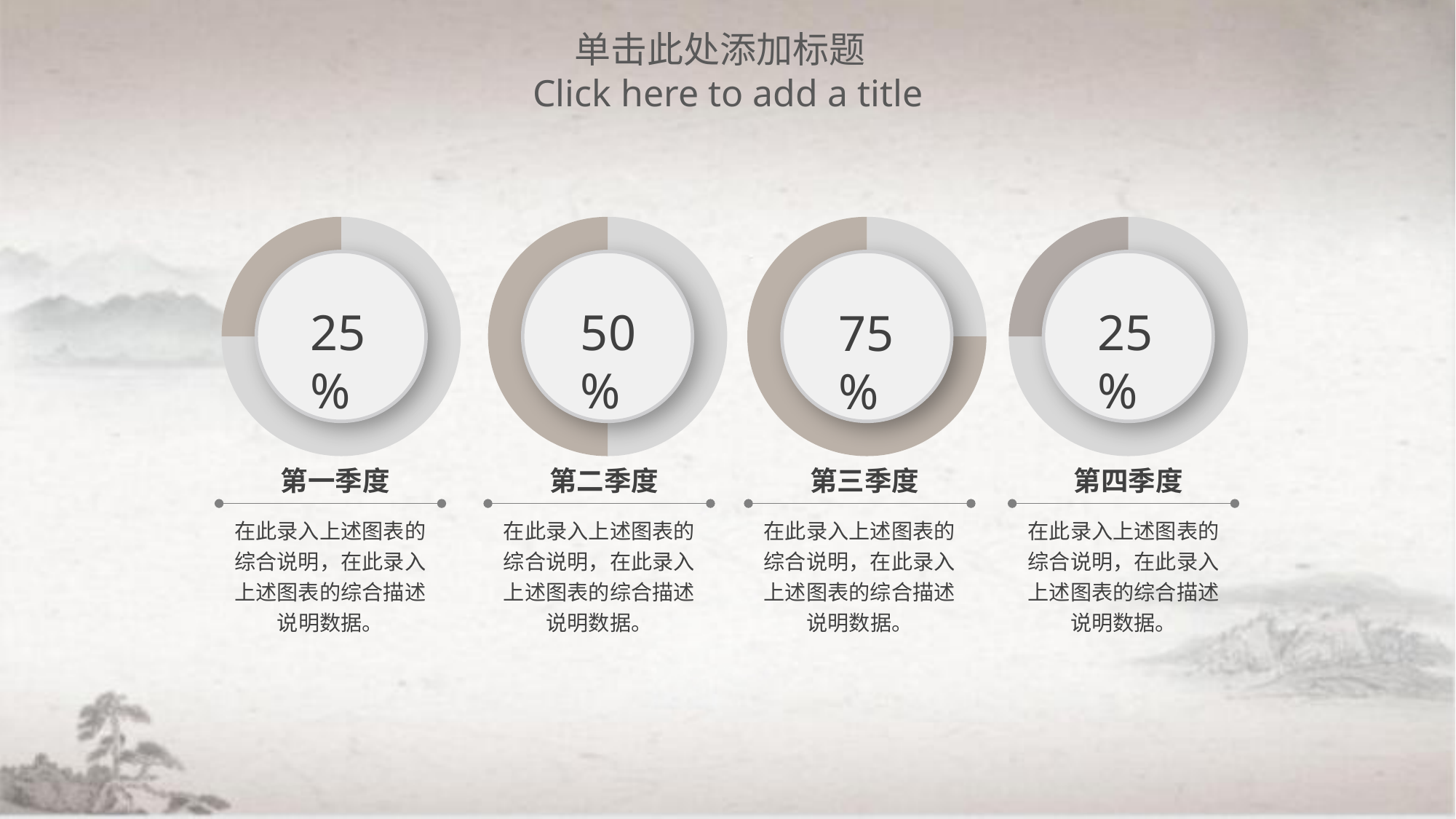
Which is larger, the 第二季度 value or the 第三季度 value? 第三季度 What kind of chart is used for each quarter on the slide? Donut chart Do the values rise or fall from 第一季度 to 第三季度? Rise What value is shown in the 第一季度 donut chart? 25% What is the difference between the 第二季度 value and the 第四季度 value? 25% How many donut charts are shown on the slide? 4 Which quarter has the highest percentage among the four donut charts? 第三季度 What share of the 第三季度 donut is filled with the darker colour? 75% What is the difference between the 第三季度 value and the 第一季度 value? 50% What value is shown in the 第二季度 donut chart? 50% What value is shown in the 第四季度 donut chart? 25% What value is shown in the 第三季度 donut chart? 75%